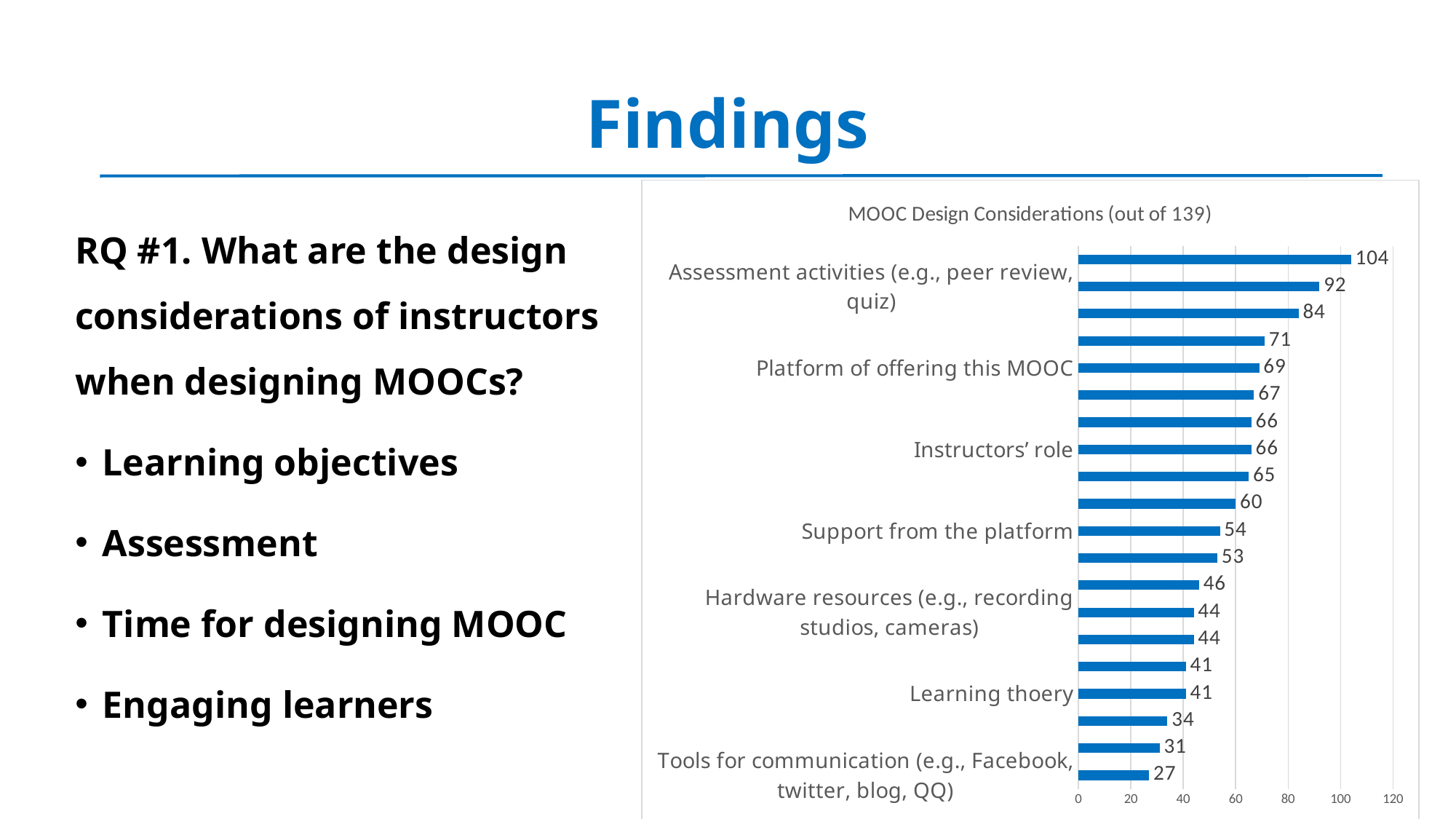
How many bars are plotted in the chart? 20 What is the value for Platform of offering this MOOC? 69 What is the value for Assessment activities (e.g., peer review, quiz)? 92 Which labeled category has the lowest value in the chart? Tools for communication (e.g., Facebook, twitter, blog, QQ) What is the title of the chart? MOOC Design Considerations (out of 139) Which is larger, the value for Support from the platform or the value for Hardware resources (e.g., recording studios, cameras)? Support from the platform What kind of chart is shown on the slide? bar chart What is the value for Tools for communication (e.g., Facebook, twitter, blog, QQ)? 27 What is the difference between the values for Assessment activities (e.g., peer review, quiz) and Platform of offering this MOOC? 23 What is the value for Learning thoery? 41 What is the highest value shown in the chart? 104 What is the value for Support from the platform? 54